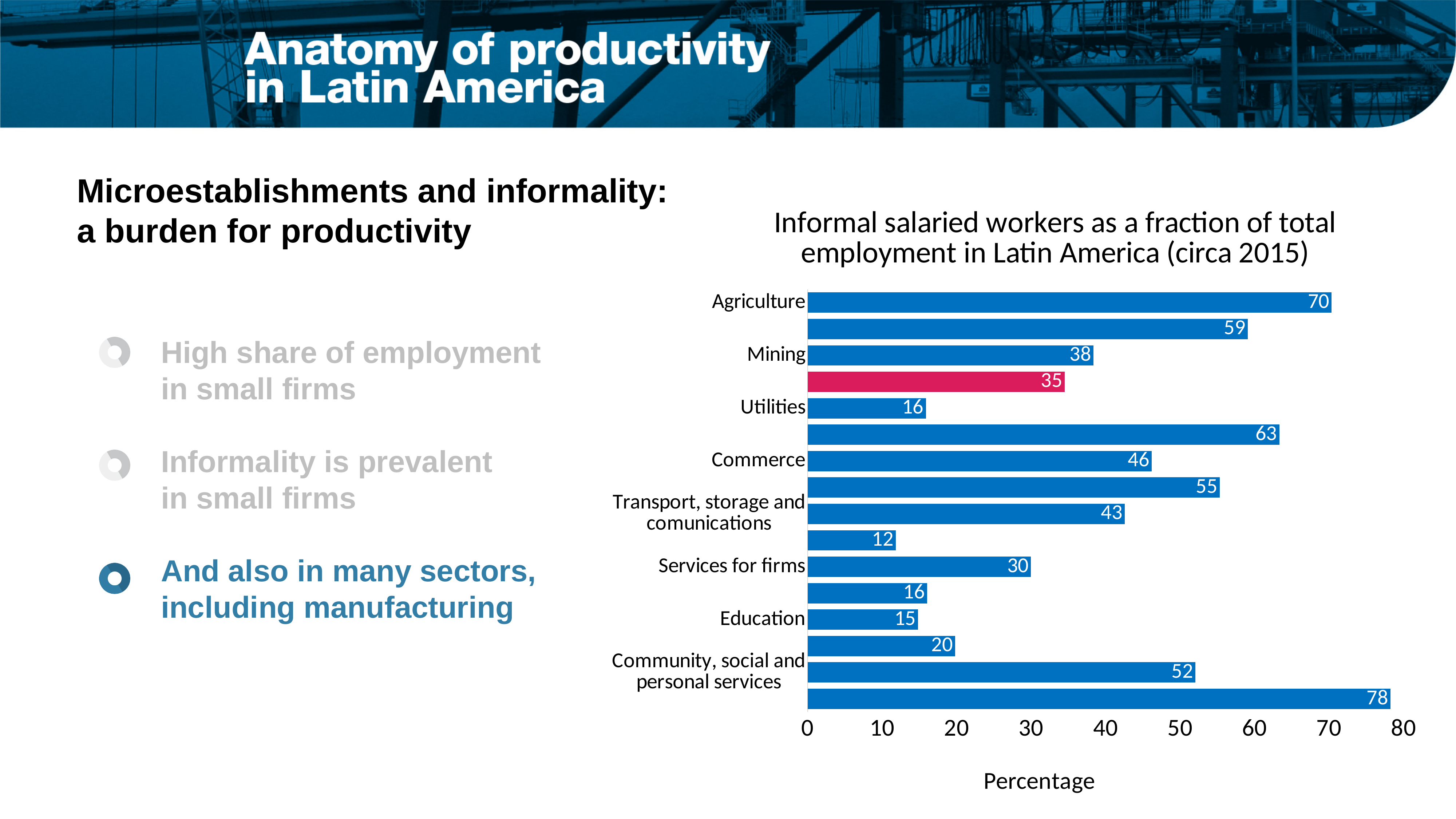
What kind of chart is shown on the slide? bar chart Is the value for Services for firms greater or less than 40? less What is the value of the longest bar in the chart? 78 What is the value of the shortest bar in the chart? 12 What is the value for Mining? 38 What is the value of the bar highlighted in red? 35 What is the difference between the values for Agriculture and Mining? 32 What is the value for Commerce? 46 What is the value for Community, social and personal services? 52 What is the value for Agriculture? 70 Which has a larger value, Agriculture or Commerce? Agriculture What is the value for Education? 15